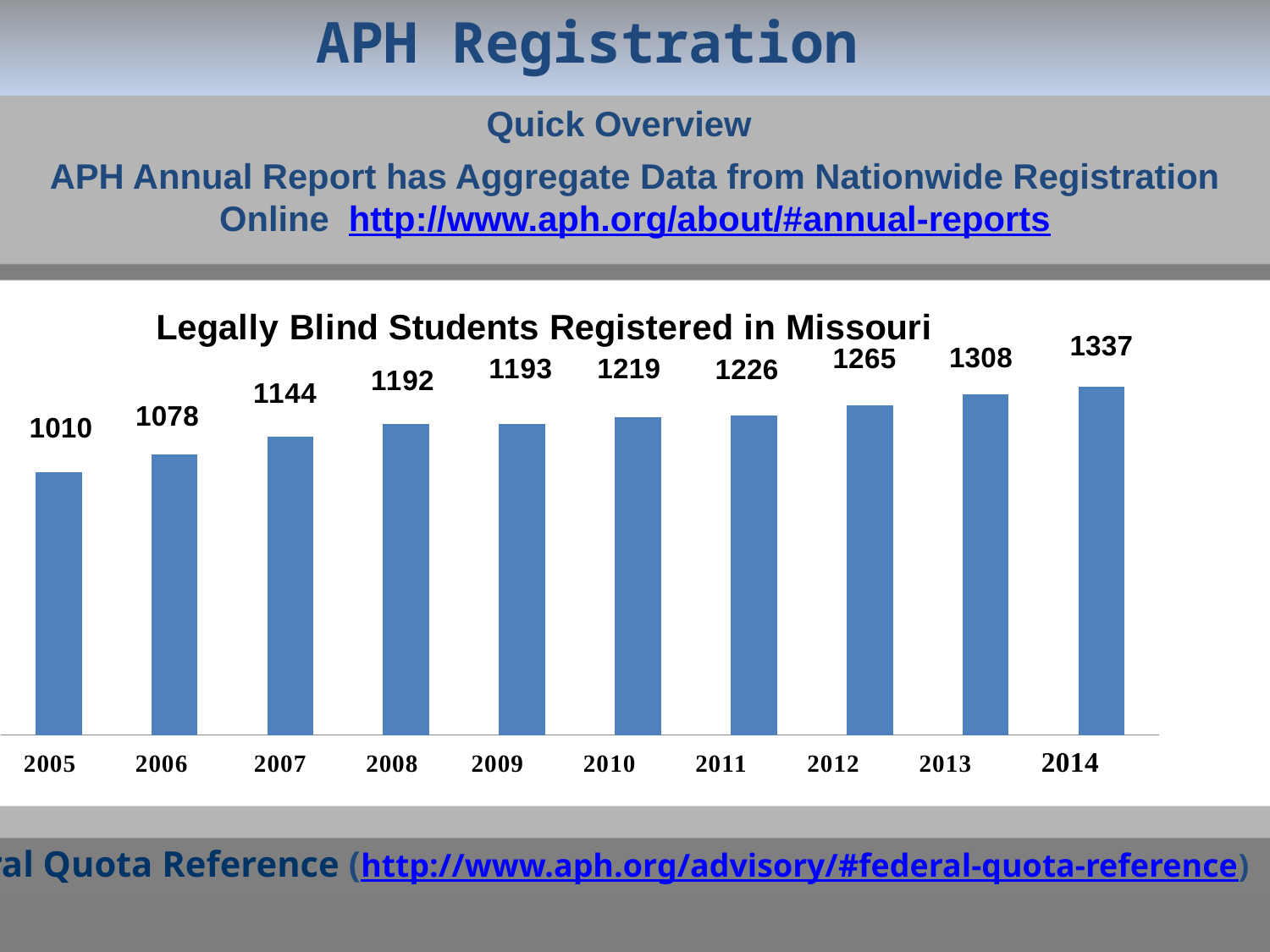
How many years are shown on the x axis? 10 What is the difference between the values for 2013 and 2012? 43 What is the value shown for 2014? 1337 What is the difference between the values for 2014 and 2005? 327 What kind of chart is shown on the slide? Bar chart Which year has the lowest number of registered students? 2005 Which year has the highest number of registered students? 2014 What is the title of the chart? Legally Blind Students Registered in Missouri What is the value shown for 2011? 1226 Which year has a larger value, 2007 or 2010? 2010 Do the values rise or fall from 2005 to 2014? Rise What is the number of legally blind students registered in Missouri in 2005? 1010